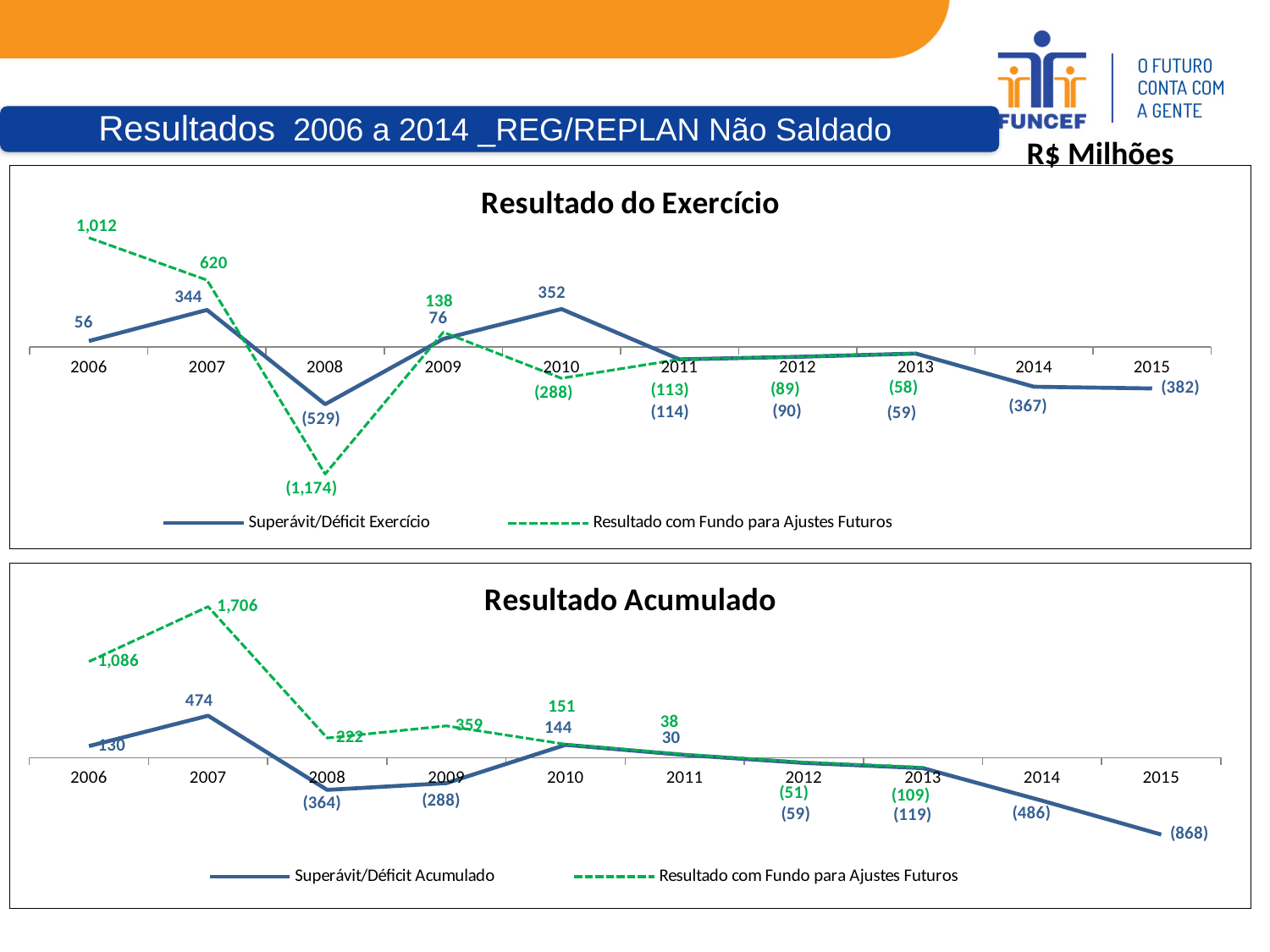
In the 'Resultado do Exercício' chart, which year has the lowest value for Resultado com Fundo para Ajustes Futuros? 2008 In the 'Resultado do Exercício' chart, which year has the highest value for Superávit/Déficit Exercício? 2010 In the 'Resultado do Exercício' chart, what is the value of Resultado com Fundo para Ajustes Futuros for 2006? 1,012 What type of chart is 'Resultado Acumulado'? Line chart In the 'Resultado do Exercício' chart, how many series does the legend list? 2 In the 'Resultado do Exercício' chart, what is the value of Superávit/Déficit Exercício for 2010? 352 In the 'Resultado Acumulado' chart, which is larger in 2009: Superávit/Déficit Acumulado or Resultado com Fundo para Ajustes Futuros? Resultado com Fundo para Ajustes Futuros In the 'Resultado do Exercício' chart, what is the difference between the Superávit/Déficit Exercício values for 2007 and 2006? 288 In the 'Resultado Acumulado' chart, what is the value of Resultado com Fundo para Ajustes Futuros for 2007? 1,706 In the 'Resultado Acumulado' chart, what is the value of Superávit/Déficit Acumulado for 2015? (868) In the 'Resultado Acumulado' chart, which year has the highest value for Superávit/Déficit Acumulado? 2007 In the 'Resultado Acumulado' chart, how many years are shown on the x axis? 10